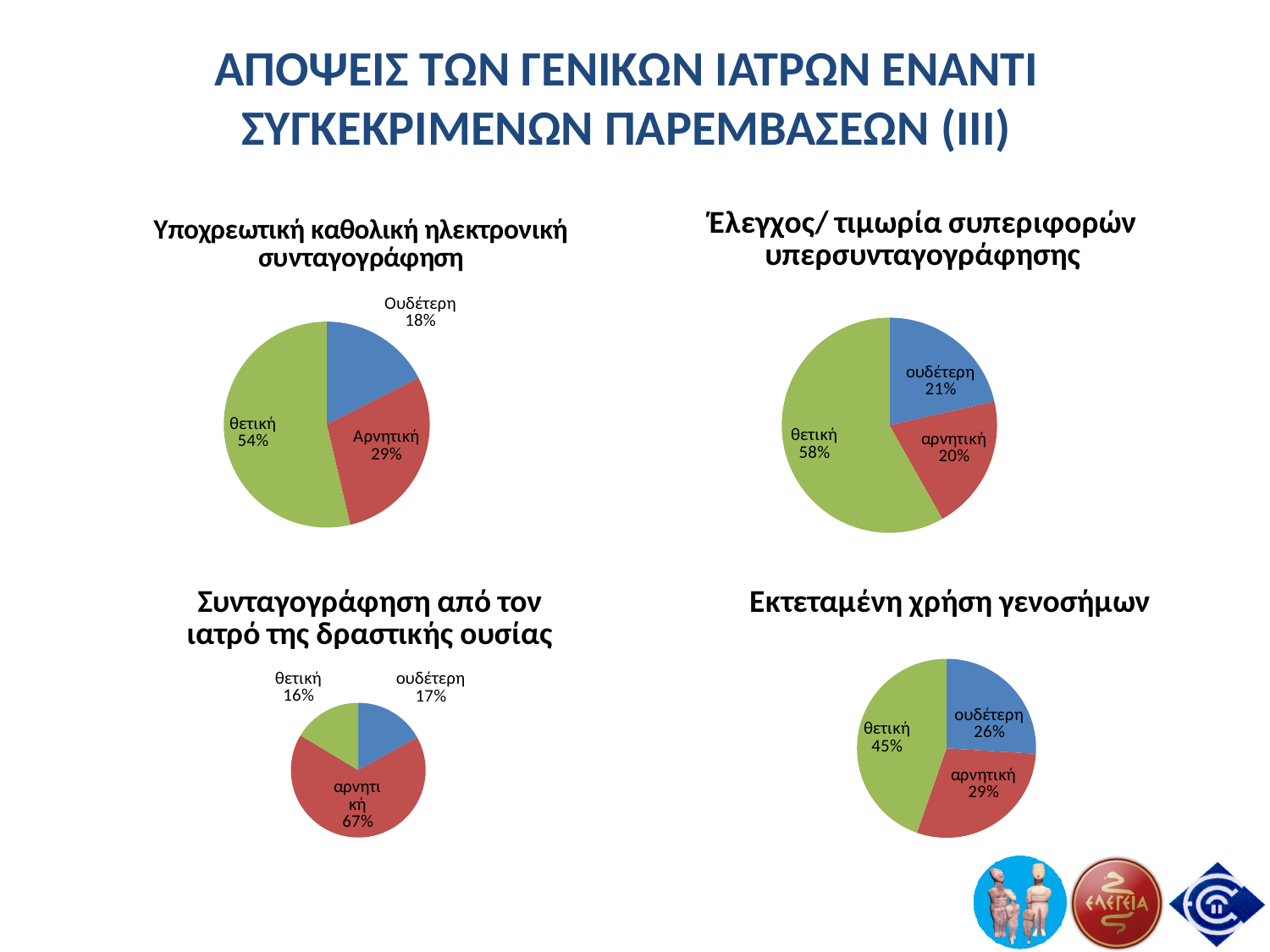
In the chart titled "Έλεγχος/ τιμωρία συπεριφορών υπερσυνταγογράφησης", what is the difference between "θετική" and "αρνητική"? 38% In the chart titled "Έλεγχος/ τιμωρία συπεριφορών υπερσυνταγογράφησης", what is the value for "ουδέτερη"? 21% In the chart titled "Έλεγχος/ τιμωρία συπεριφορών υπερσυνταγογράφησης", which category has the largest slice? θετική In the chart titled "Υποχρεωτική καθολική ηλεκτρονική συνταγογράφηση", what is the value for "Αρνητική"? 29% How many slices does the chart titled "Υποχρεωτική καθολική ηλεκτρονική συνταγογράφηση" have? 3 In the chart titled "Συνταγογράφηση από τον ιατρό της δραστικής ουσίας", which category has the smallest slice? θετική In the chart titled "Συνταγογράφηση από τον ιατρό της δραστικής ουσίας", what share is labelled "αρνητική"? 67% In the chart titled "Εκτεταμένη χρήση γενοσήμων", what is the difference between "αρνητική" and "ουδέτερη"? 3% What type of chart is used for "Εκτεταμένη χρήση γενοσήμων"? Pie chart In the chart titled "Υποχρεωτική καθολική ηλεκτρονική συνταγογράφηση", what share is labelled "θετική"? 54% In the chart titled "Εκτεταμένη χρήση γενοσήμων", what is the value for "ουδέτερη"? 26% In the chart titled "Εκτεταμένη χρήση γενοσήμων", which is larger, "θετική" or "αρνητική"? θετική